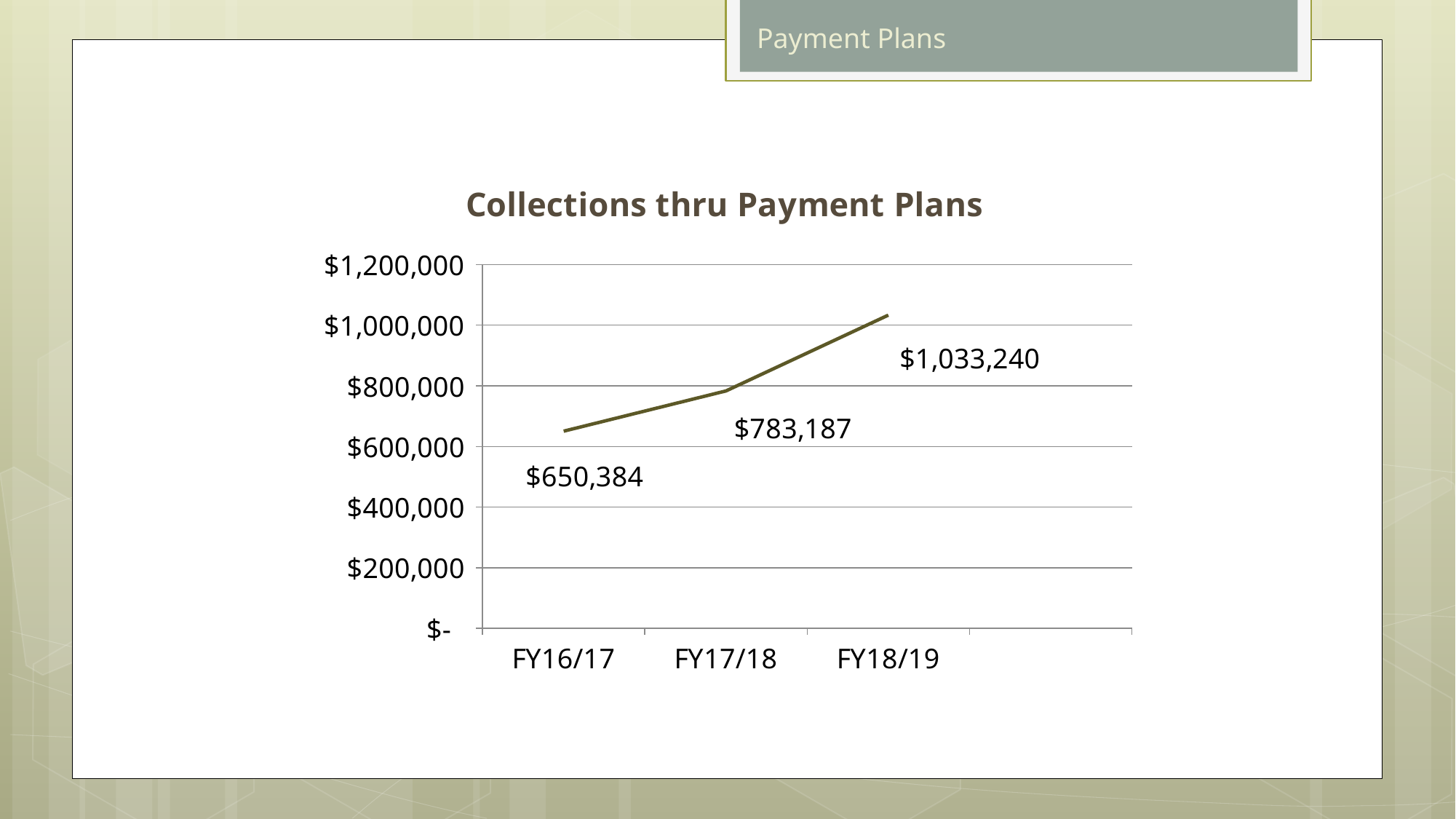
Do the values rise or fall from FY16/17 to FY18/19? rise Which fiscal year has the highest collections? FY18/19 How many fiscal years are plotted on the chart? 3 What kind of chart is shown? line chart What is the difference between the FY17/18 and FY16/17 values? $132,803 Which is larger, the value for FY16/17 or FY17/18? FY17/18 What is the value for FY16/17? $650,384 Which fiscal year has the lowest collections? FY16/17 Is the value for FY18/19 greater or less than $1,000,000? greater What is the difference between the FY18/19 and FY17/18 values? $250,053 What is the value for FY18/19? $1,033,240 What is the value for FY17/18? $783,187